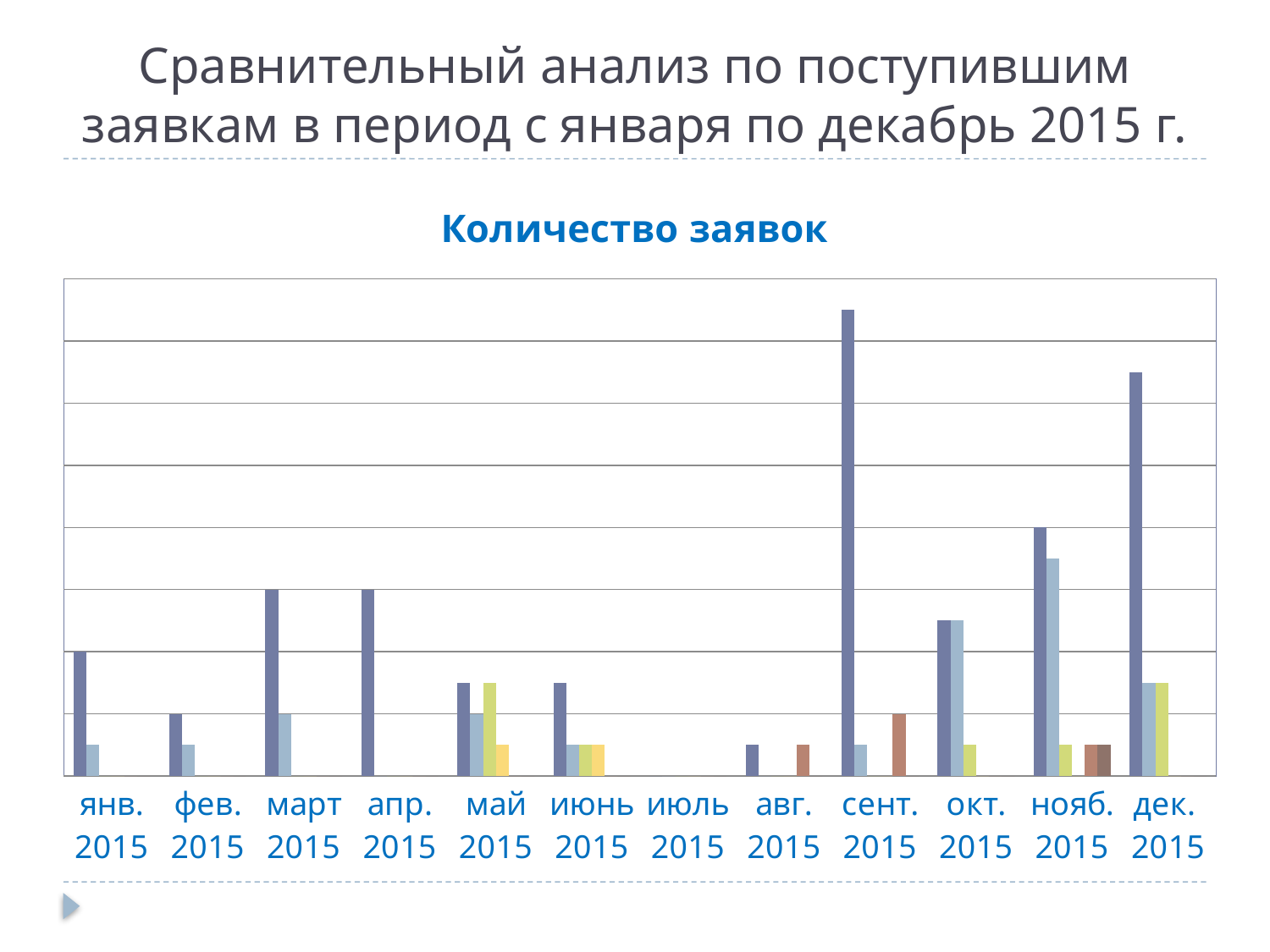
Is the tallest bar for авг. 2015 or for июнь 2015 higher? июнь 2015 Is the tallest bar for янв. 2015 or for фев. 2015 higher? янв. 2015 Is the tallest bar for сент. 2015 or for дек. 2015 higher? сент. 2015 What kind of chart is shown on the slide? bar chart How many months are shown on the x axis of the chart? 12 Which month has no bars at all in the chart? июль 2015 Which month has the tallest bar in the chart? сент. 2015 Which month has the second tallest bar in the chart? дек. 2015 What is the title of the chart? Количество заявок